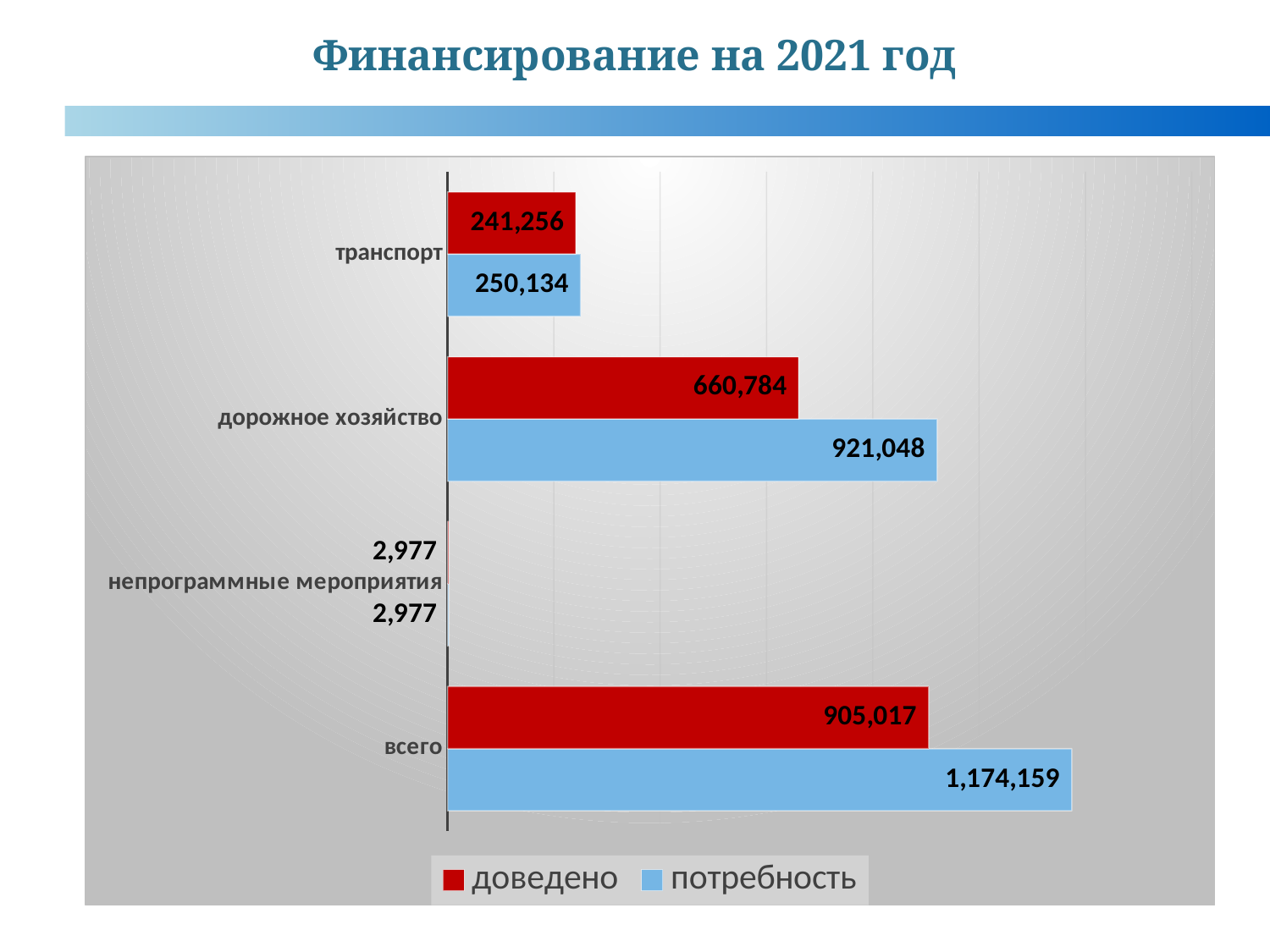
Which category has the highest доведено value? всего How many categories are shown on the chart? 4 What is the value of доведено for транспорт? 241,256 How many series does the legend list? 2 What is the value of потребность for дорожное хозяйство? 921,048 What type of chart is shown on the slide? bar chart What is the difference between потребность and доведено for всего? 269,142 What is the difference between потребность and доведено for дорожное хозяйство? 260,264 What is the value of потребность for всего? 1,174,159 Which category has the lowest потребность value? непрограммные мероприятия What is the value of доведено for непрограммные мероприятия? 2,977 Which is larger for транспорт: доведено or потребность? потребность